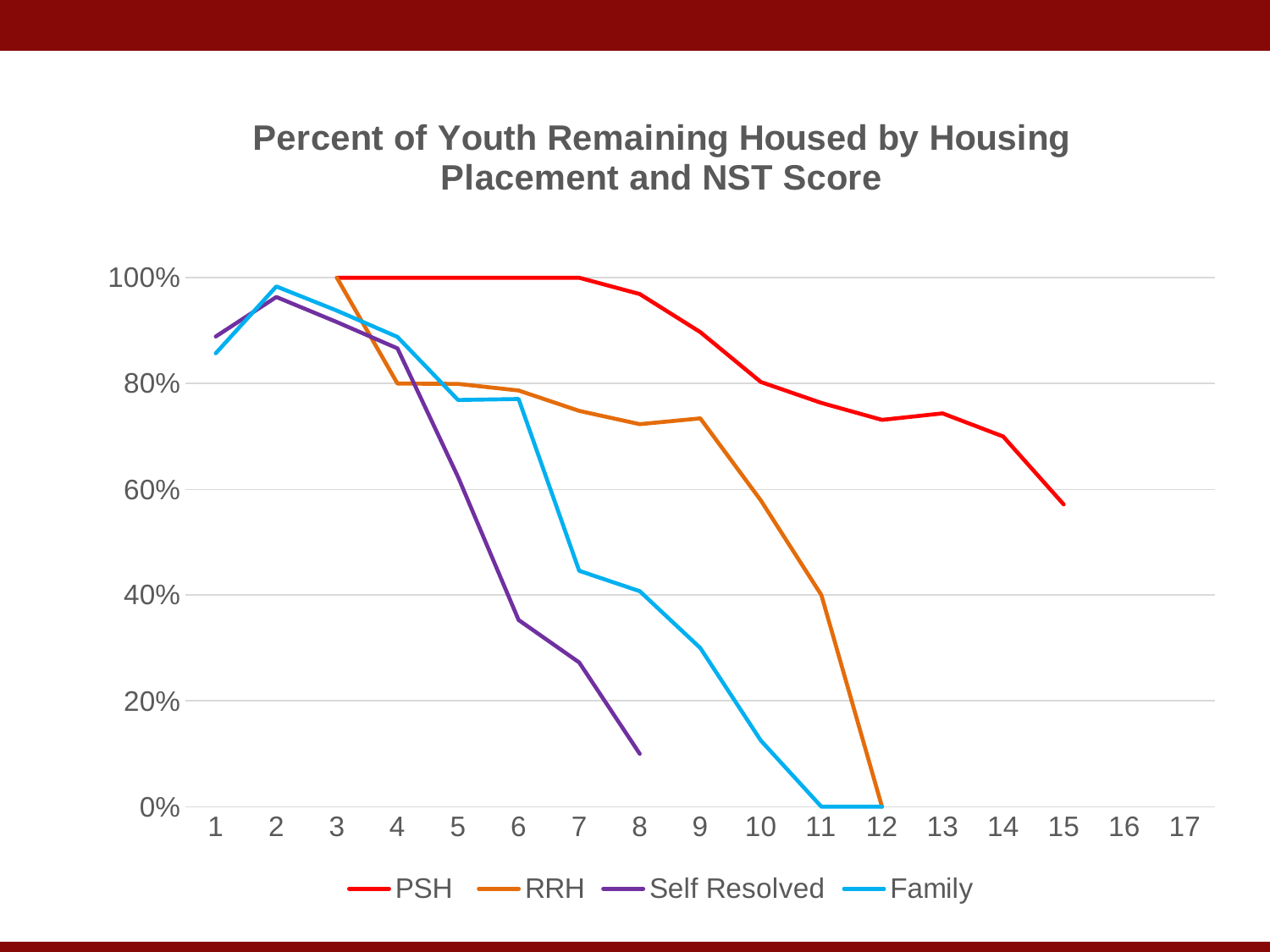
What is the value for RRH at NST score 12? 0% What is the value for PSH at NST score 5? 100% At NST score 6, which is larger, RRH or Self Resolved? RRH What is the value for Family at NST score 11? 0% What is the title of the chart? Percent of Youth Remaining Housed by Housing Placement and NST Score Which series has the highest value at NST score 9? PSH Is the value for RRH at NST score 11 greater or less than 60%? less Is the value for Self Resolved at NST score 8 greater or less than 20%? less What kind of chart is shown on the slide? line chart At NST score 10, which is larger, PSH or Family? PSH Is the value for PSH at NST score 15 greater or less than 80%? less How many series does the legend list? 4